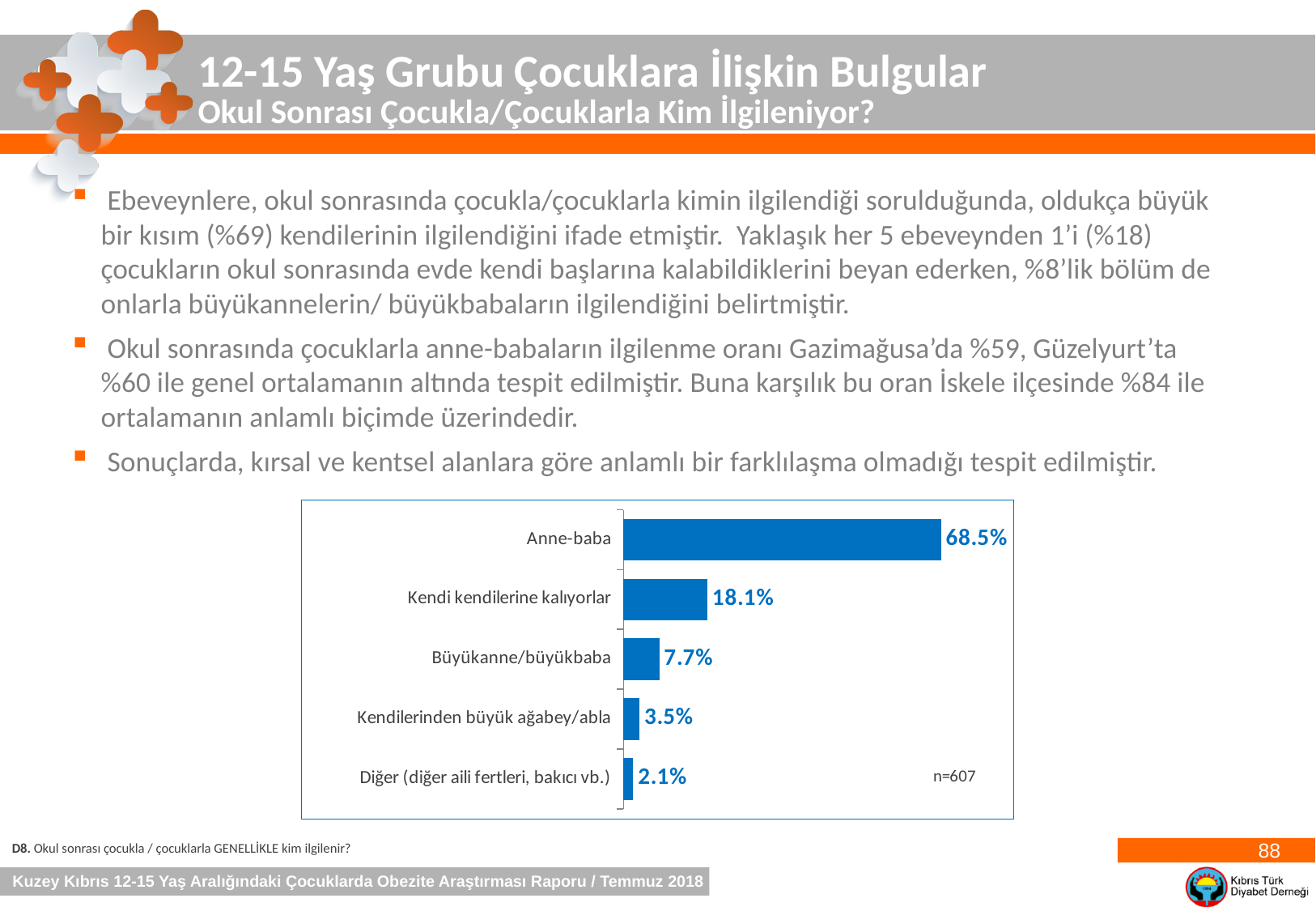
What sample size (n) is shown on the chart? n=607 Which is larger, the value for Büyükanne/büyükbaba or the value for Kendilerinden büyük ağabey/abla? Büyükanne/büyükbaba What kind of chart is shown on the slide? Bar chart What is the value for Diğer (diğer aili fertleri, bakıcı vb.)? 2.1% How many categories are shown in the chart? 5 Which category has the highest value? Anne-baba What is the difference between the values for Anne-baba and Kendi kendilerine kalıyorlar? 50.4% What is the value for Kendilerinden büyük ağabey/abla? 3.5% Which category has the lowest value? Diğer (diğer aili fertleri, bakıcı vb.) What is the value for Anne-baba? 68.5% What is the value for Büyükanne/büyükbaba? 7.7% What is the value for Kendi kendilerine kalıyorlar? 18.1%